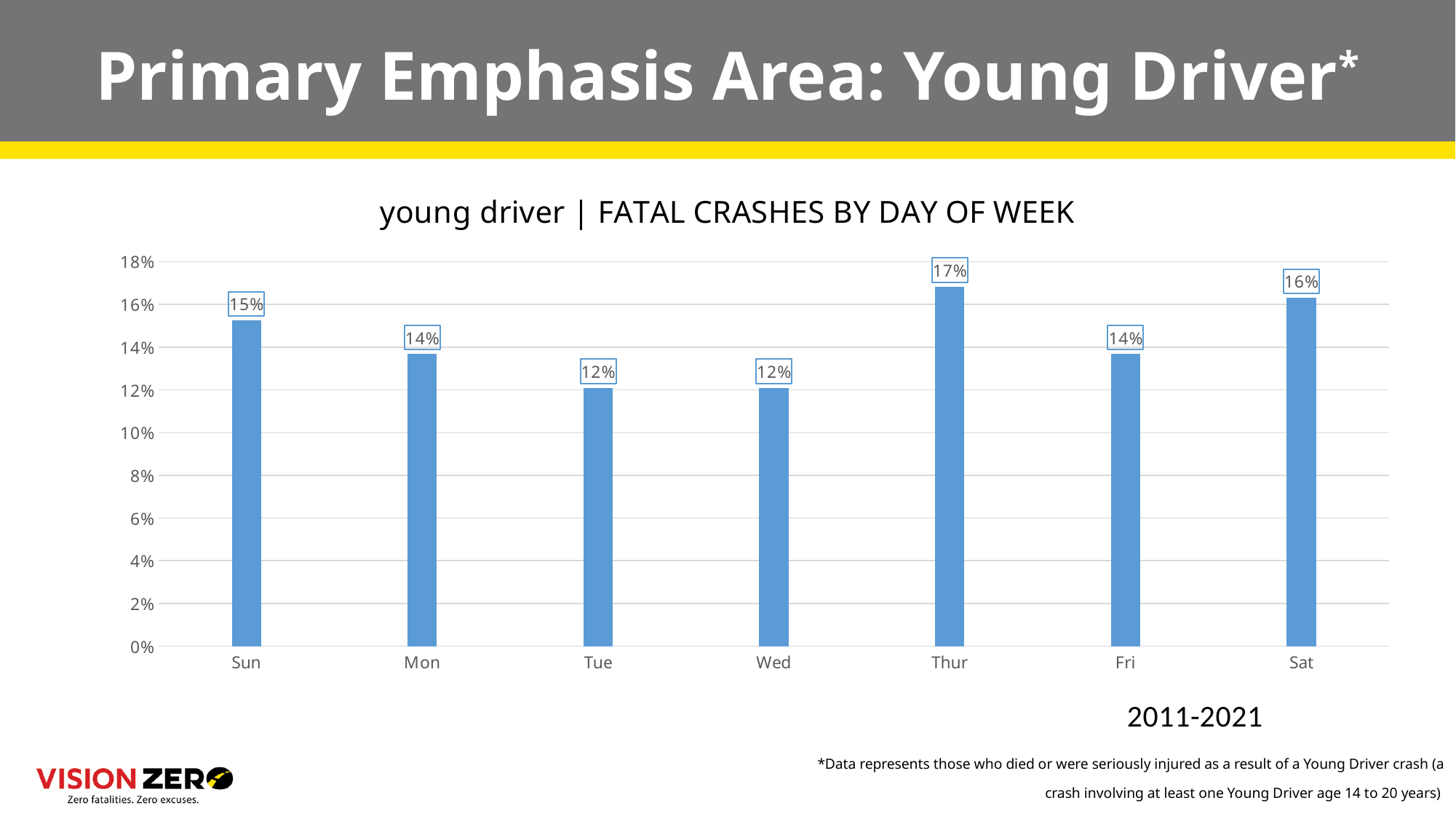
What is the value for Sun? 15% What is the title of the chart? young driver | FATAL CRASHES BY DAY OF WEEK What is the value for Sat? 16% What is the difference between the values for Thur and Wed? 5% How many days of the week are shown on the x axis? 7 Is the value for Tue greater or less than 14%? less What kind of chart is shown on the slide? bar chart Which is larger, the value for Sat or the value for Mon? Sat What year range is shown below the chart? 2011-2021 Which day of the week has the highest share of fatal crashes? Thur Do the values rise or fall from Sun to Tue? fall What is the value for Thur? 17%